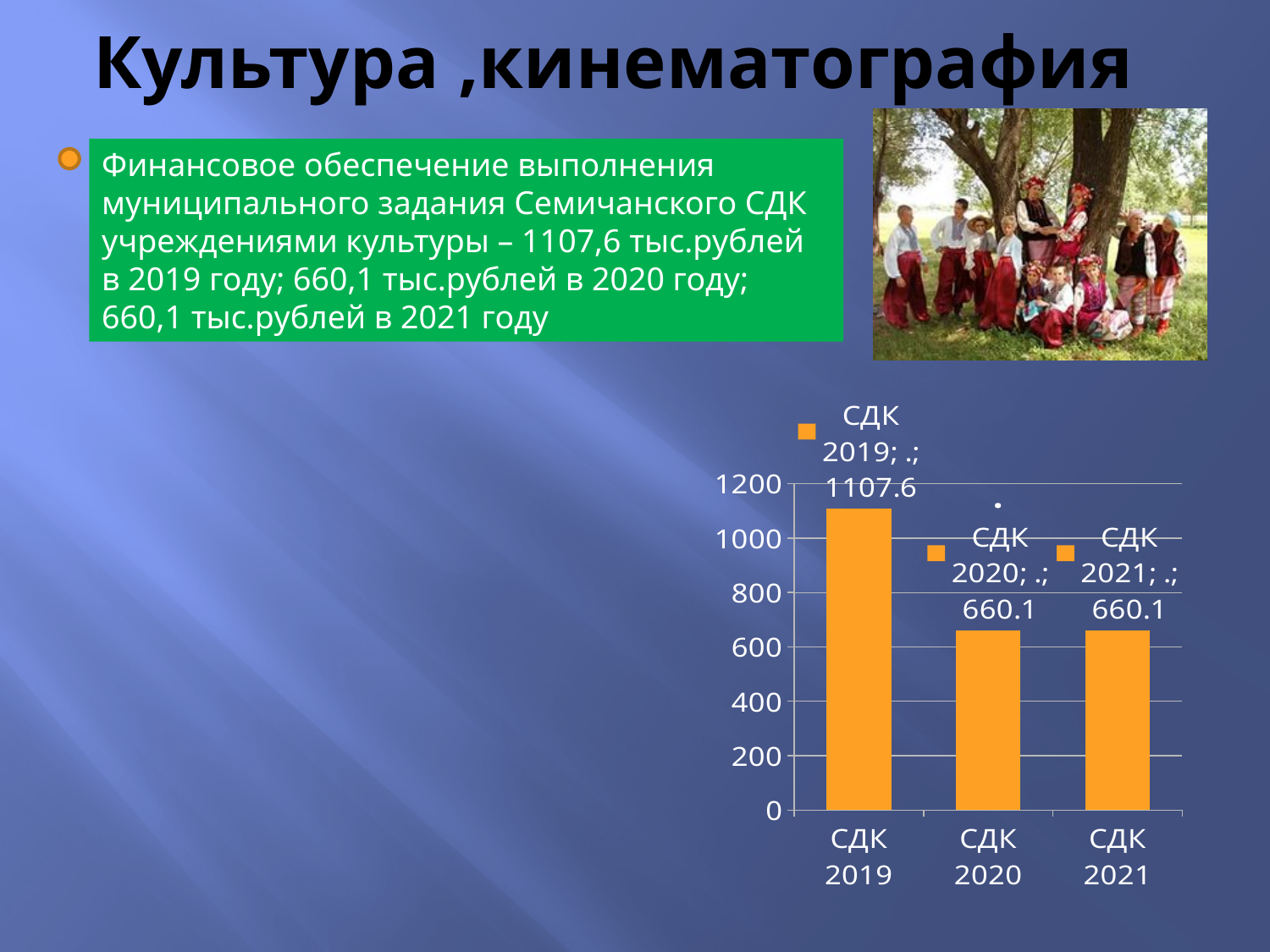
What colour are the bars in the chart? orange What is the difference between the values for СДК 2019 and СДК 2020? 447.5 What is the value for СДК 2021? 660.1 What kind of chart is shown on the slide? bar chart Is the value for СДК 2020 greater or less than 800? less Do the values rise or fall from СДК 2019 to СДК 2020? fall How many bars are shown in the chart? 3 Which category has the highest value? СДК 2019 What is the value for СДК 2019? 1107.6 What is the value for СДК 2020? 660.1 Is the value for СДК 2019 greater or less than 1000? greater Which is larger, the value for СДК 2019 or the value for СДК 2021? СДК 2019